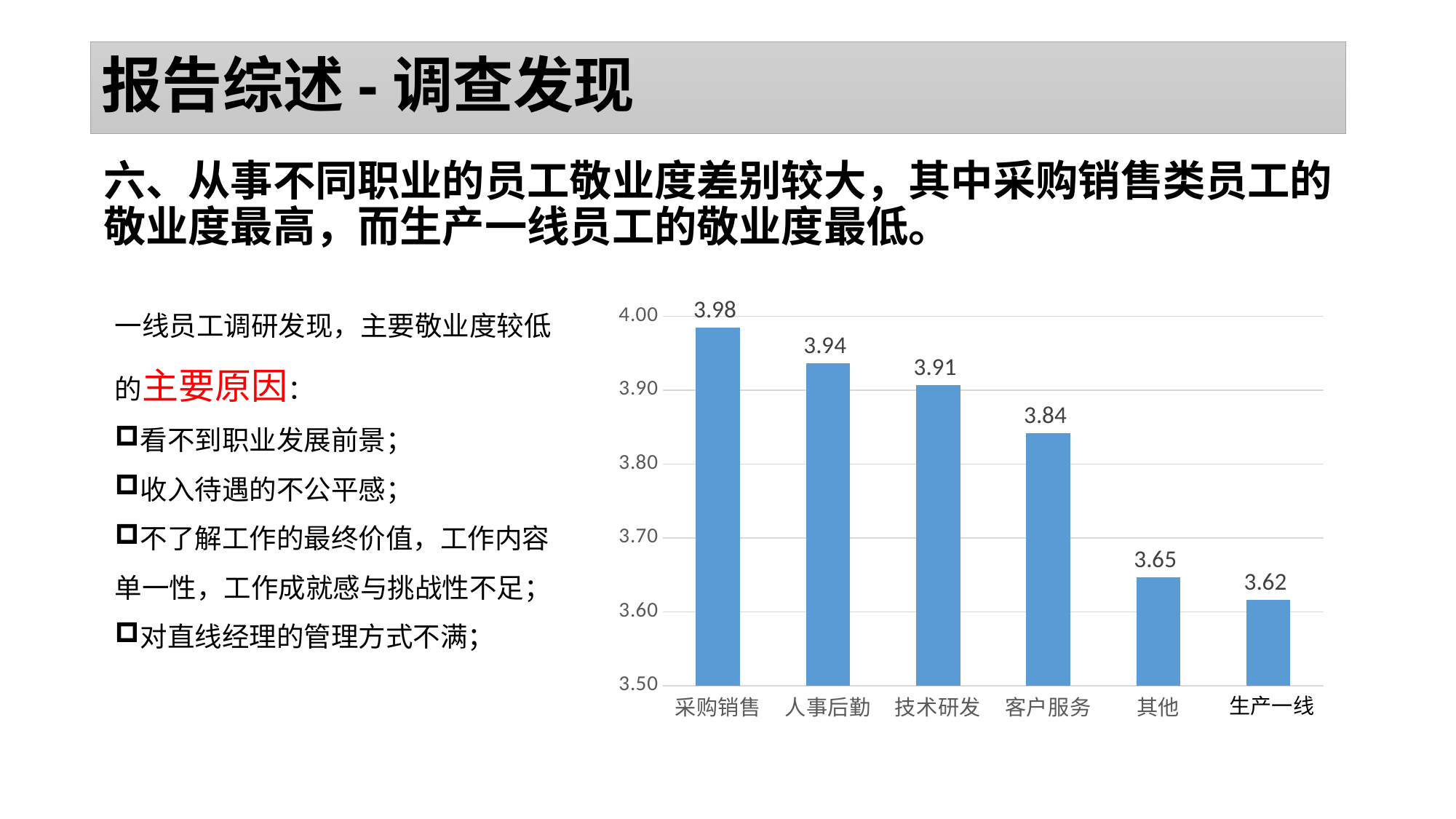
What is the value for 其他? 3.65 How many categories are shown on the x axis? 6 Which category has the lowest value? 生产一线 What is the value for 生产一线? 3.62 What is the value for 采购销售? 3.98 What is the value for 客户服务? 3.84 What is the difference between the values for 采购销售 and 生产一线? 0.36 Which is larger, the value for 技术研发 or the value for 其他? 技术研发 What kind of chart is shown on the slide? bar chart Is the value for 客户服务 greater or less than 3.80? greater Which category has the highest value? 采购销售 What is the difference between the values for 人事后勤 and 客户服务? 0.10